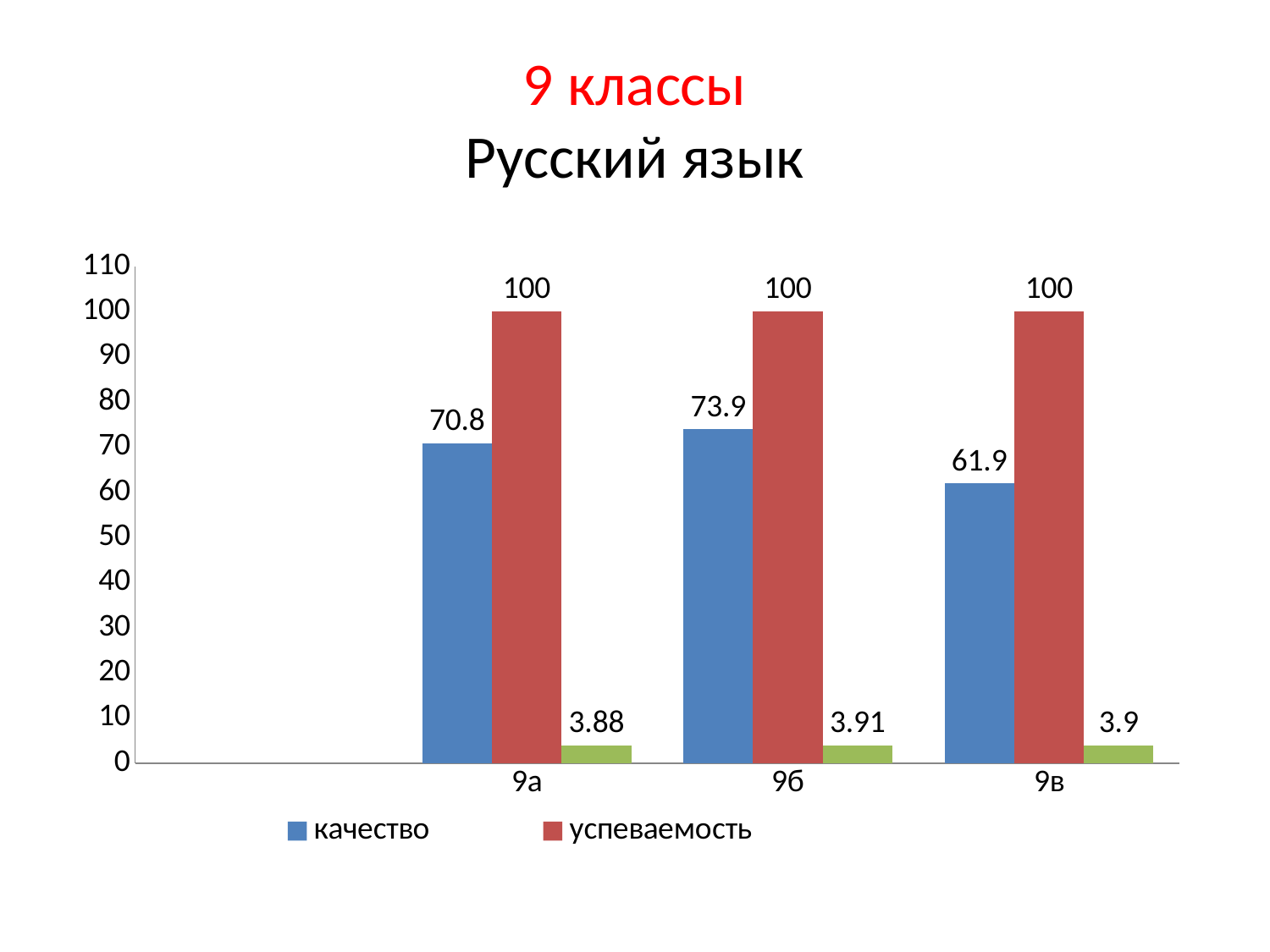
How many classes are shown on the x axis? 3 What kind of chart is shown on the slide? bar chart What is the value of качество for 9б? 73.9 Which class has the highest качество value? 9б Which is larger, the качество value for 9а or for 9б? 9б What is the value of качество for 9а? 70.8 Which class has the lowest качество value? 9в What is the value of the green bar for 9б? 3.91 How many series does the legend list? 2 What is the value of успеваемость for 9в? 100 What is the value of качество for 9в? 61.9 What is the difference between the качество values for 9б and 9в? 12